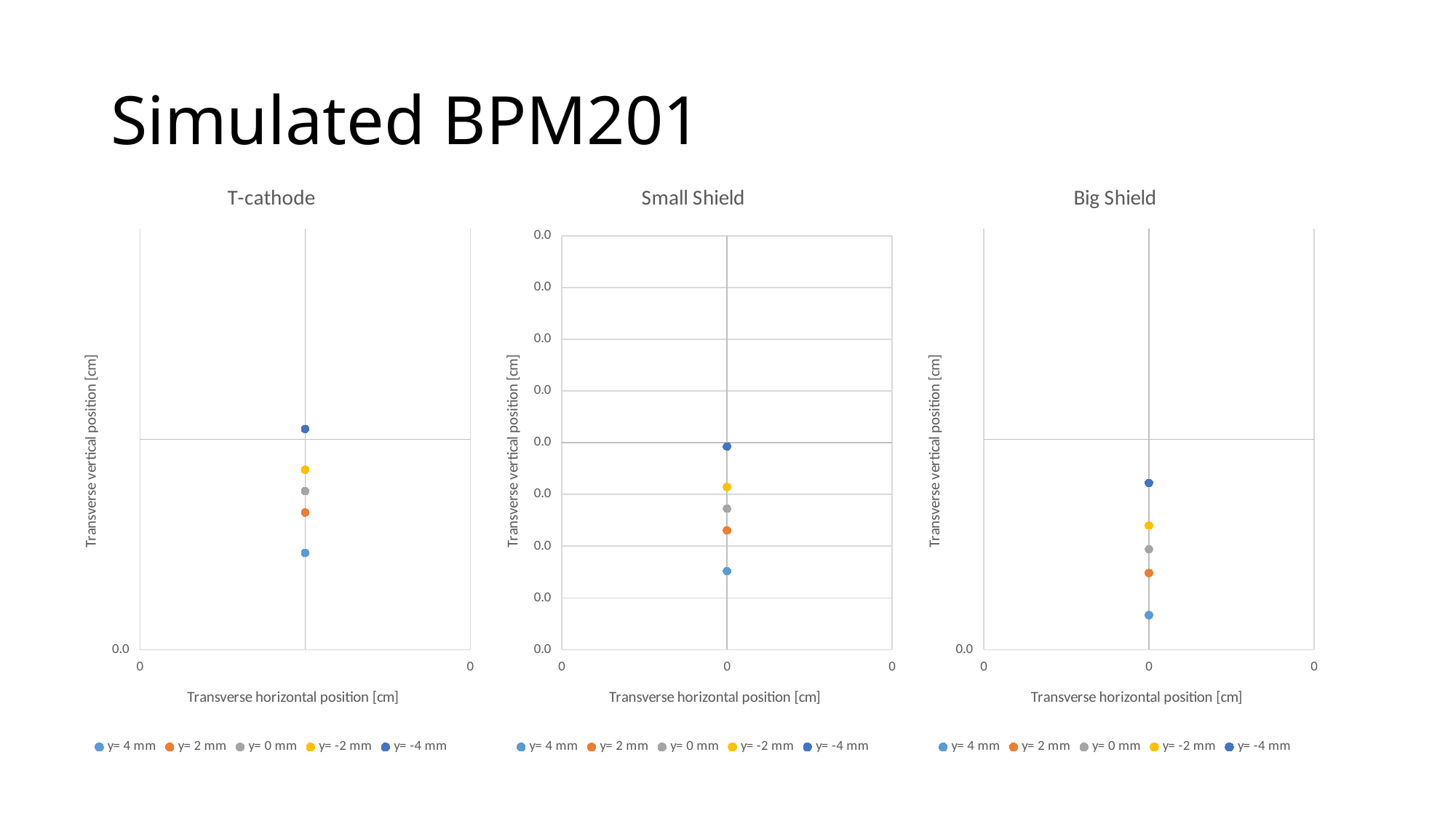
In the T-cathode chart, which series has the lowest vertical position? y= 4 mm In the Big Shield chart, which series has the lowest vertical position? y= 4 mm What kind of chart is the Small Shield chart? scatter chart How many charts are shown on the slide? 3 In the Big Shield chart, which is plotted higher vertically, y= 2 mm or y= -2 mm? y= -2 mm What is the title of the rightmost chart? Big Shield How many data points are plotted in the Big Shield chart? 5 In the Small Shield chart, which is plotted higher vertically, y= 0 mm or y= 4 mm? y= 0 mm In the Small Shield chart, which series has the highest vertical position? y= -4 mm How many series does the legend of the T-cathode chart list? 5 In the T-cathode chart, which series has the highest vertical position? y= -4 mm What is the title of the leftmost chart? T-cathode